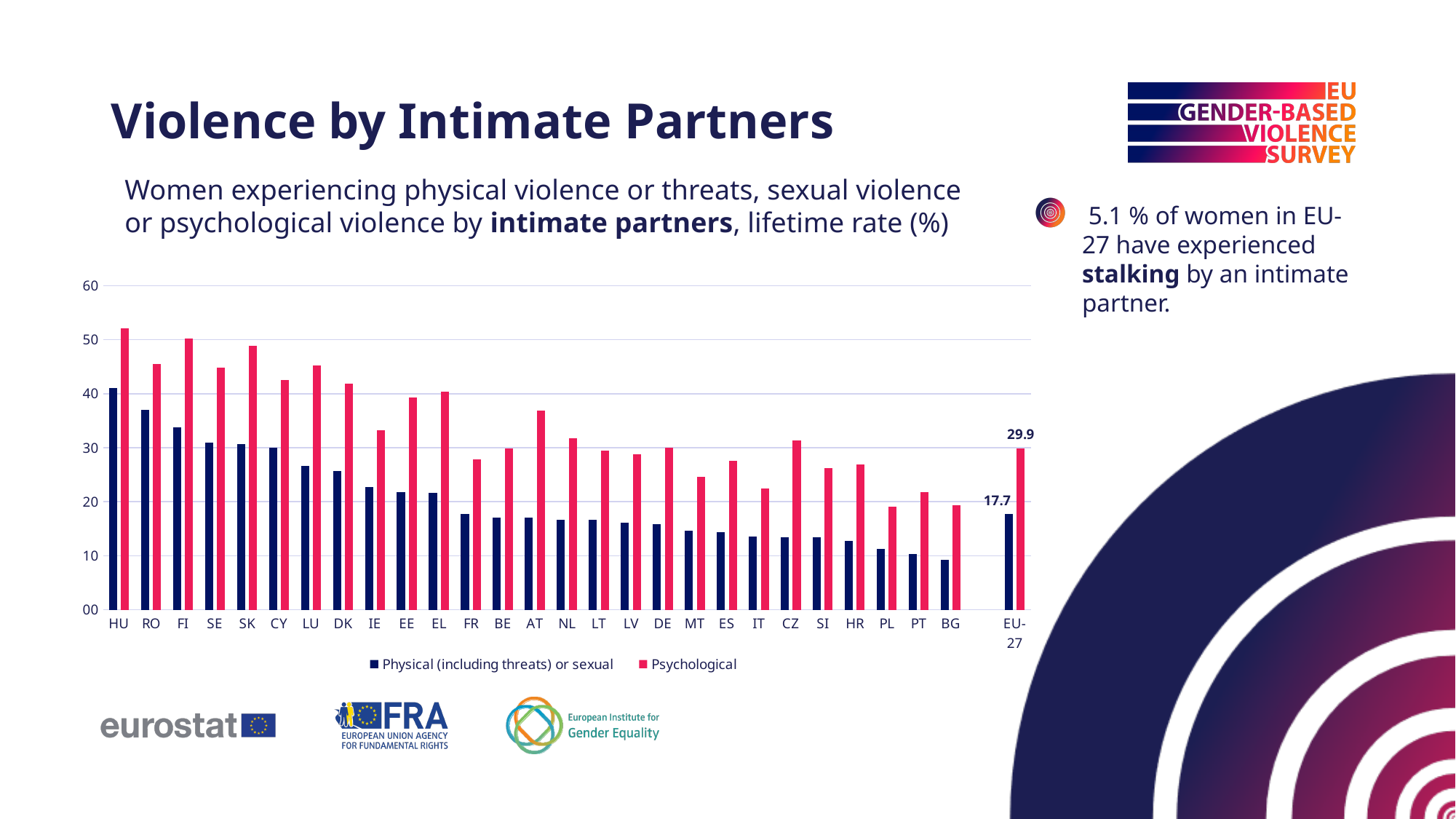
What type of chart is shown on the slide? bar chart How many series does the legend list? 2 What is the value for Psychological violence for EU-27? 29.9 Do the Physical (including threats) or sexual violence values generally rise or fall from HU to BG along the x axis? fall What is the difference between the Psychological and the Physical (including threats) or sexual values for EU-27? 12.2 What is the value for Physical (including threats) or sexual violence for EU-27? 17.7 What are the two series named in the legend? Physical (including threats) or sexual; Psychological Which country has the highest Physical (including threats) or sexual violence value? HU Is the Physical (including threats) or sexual violence value for BG greater or less than 10? less Is the Psychological violence value for HU greater or less than 50? greater Which country has the highest Psychological violence value? HU Which country has the lowest Physical (including threats) or sexual violence value? BG